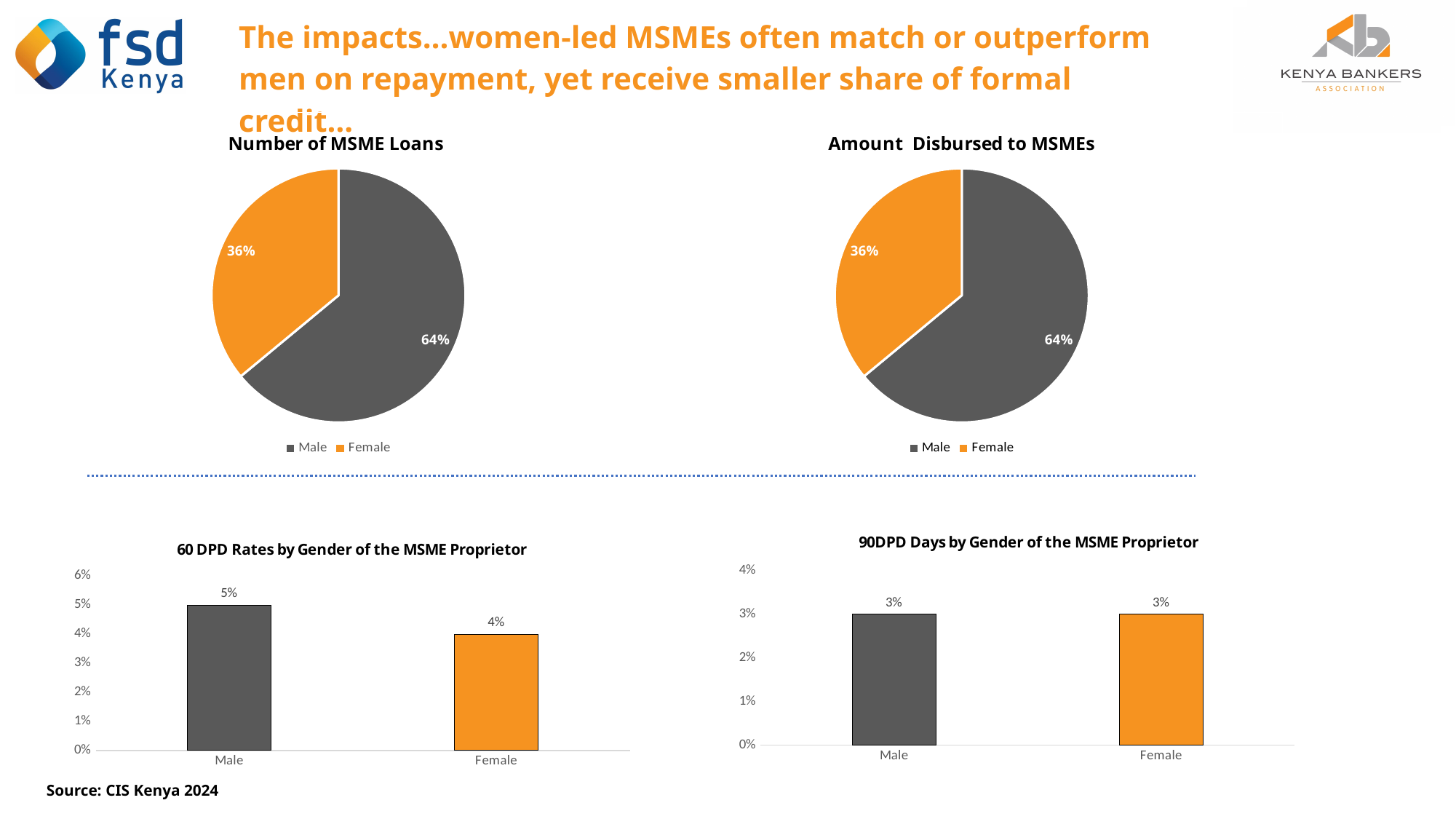
In the '60 DPD Rates by Gender of the MSME Proprietor' chart, what is the value for Female? 4% In the 'Number of MSME Loans' pie chart, what share is Male? 64% In the 'Number of MSME Loans' pie chart, what share is Female? 36% In the 'Amount Disbursed to MSMEs' pie chart, what share is Male? 64% In the '90DPD Days by Gender of the MSME Proprietor' chart, what is the value for Female? 3% In the '60 DPD Rates by Gender of the MSME Proprietor' chart, what is the value for Male? 5% How many entries does the legend of the 'Number of MSME Loans' chart list? 2 What kind of chart is '60 DPD Rates by Gender of the MSME Proprietor'? Bar chart In the '60 DPD Rates by Gender of the MSME Proprietor' chart, what is the difference between the Male and Female values? 1% In the '60 DPD Rates by Gender of the MSME Proprietor' chart, which category has the lowest value? Female In the 'Amount Disbursed to MSMEs' pie chart, which category has the larger slice? Male In the '90DPD Days by Gender of the MSME Proprietor' chart, how many categories are shown? 2